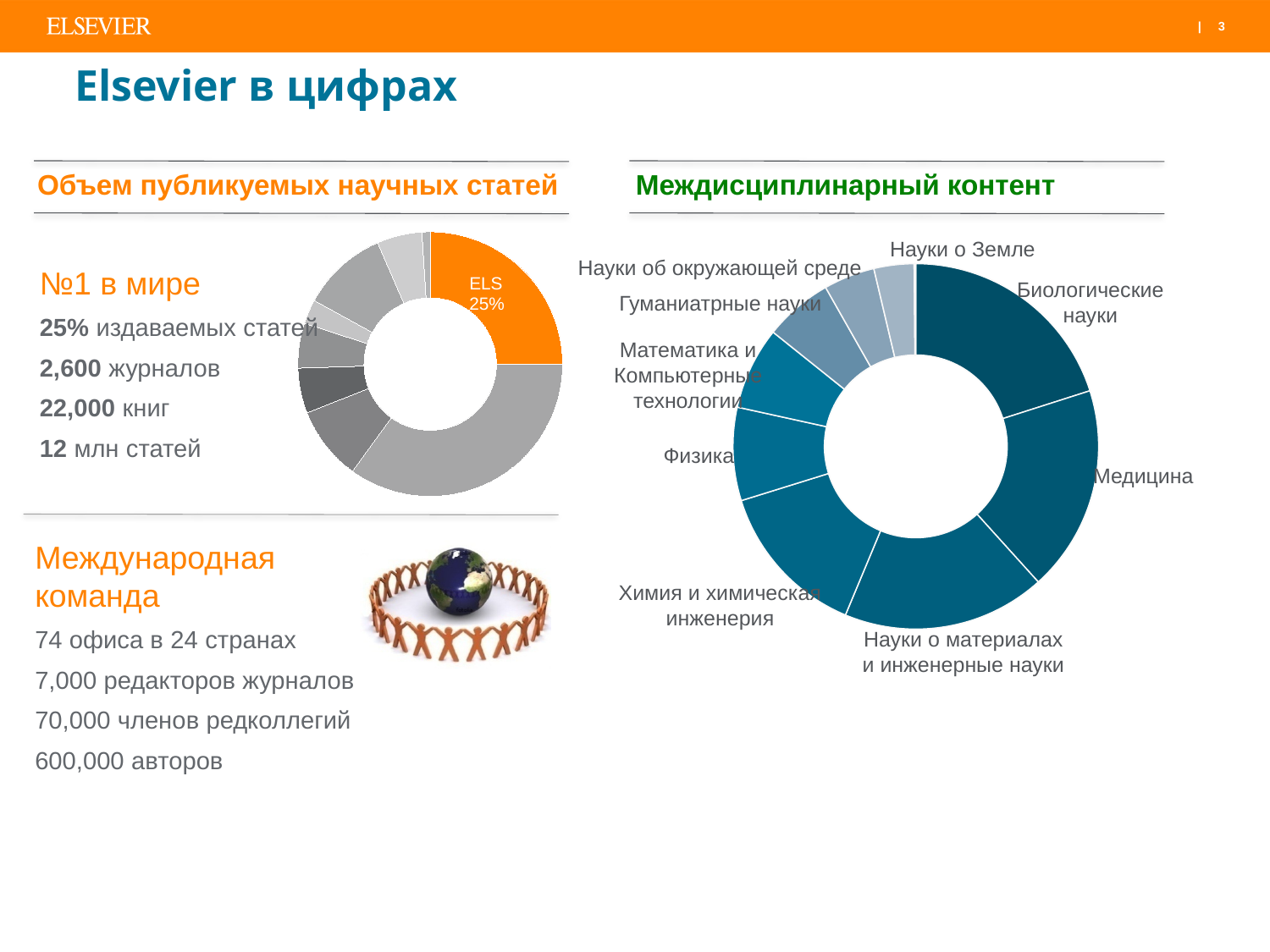
How many categories are labelled in the chart under 'Междисциплинарный контент'? 9 What is the title above the chart on the right side of the slide? Междисциплинарный контент What kind of chart is shown under 'Междисциплинарный контент'? doughnut chart In the chart under 'Междисциплинарный контент', which slice is larger: Медицина or Физика? Медицина In the chart under 'Междисциплинарный контент', which slice is larger: Биологические науки or Науки о Земле? Биологические науки In the chart under 'Междисциплинарный контент', which slice is larger: Науки о материалах и инженерные науки or Гуманиатрные науки? Науки о материалах и инженерные науки In the chart under 'Объем публикуемых научных статей', what share is labelled for ELS? 25% What kind of chart is shown under 'Объем публикуемых научных статей'? doughnut chart In the chart under 'Объем публикуемых научных статей', which slice is highlighted in orange? ELS In the chart under 'Междисциплинарный контент', which category has the largest slice? Биологические науки